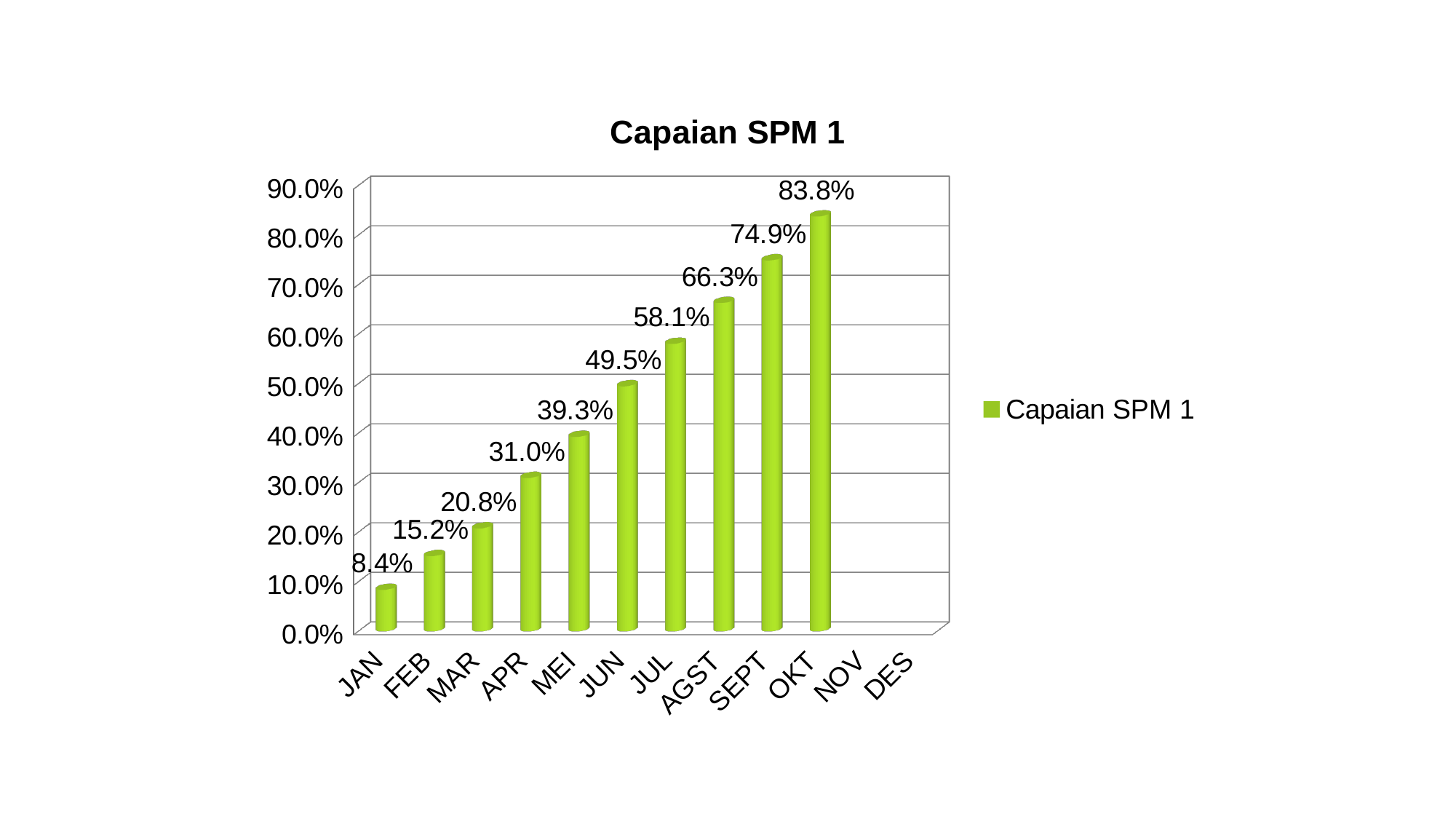
What is the value for JUN? 49.5% Which is larger, the value for APR or the value for MEI? MEI Which month has the highest value? OKT How many months have a plotted bar? 10 What is the difference between the values for SEPT and AGST? 8.6% How many series does the legend list? 1 Do the values rise or fall from JAN to OKT? rise Which month has the lowest plotted value? JAN What is the value for MAR? 20.8% Is the value for JUL greater or less than 50.0%? greater What kind of chart is shown? bar chart What is the value for OKT? 83.8%